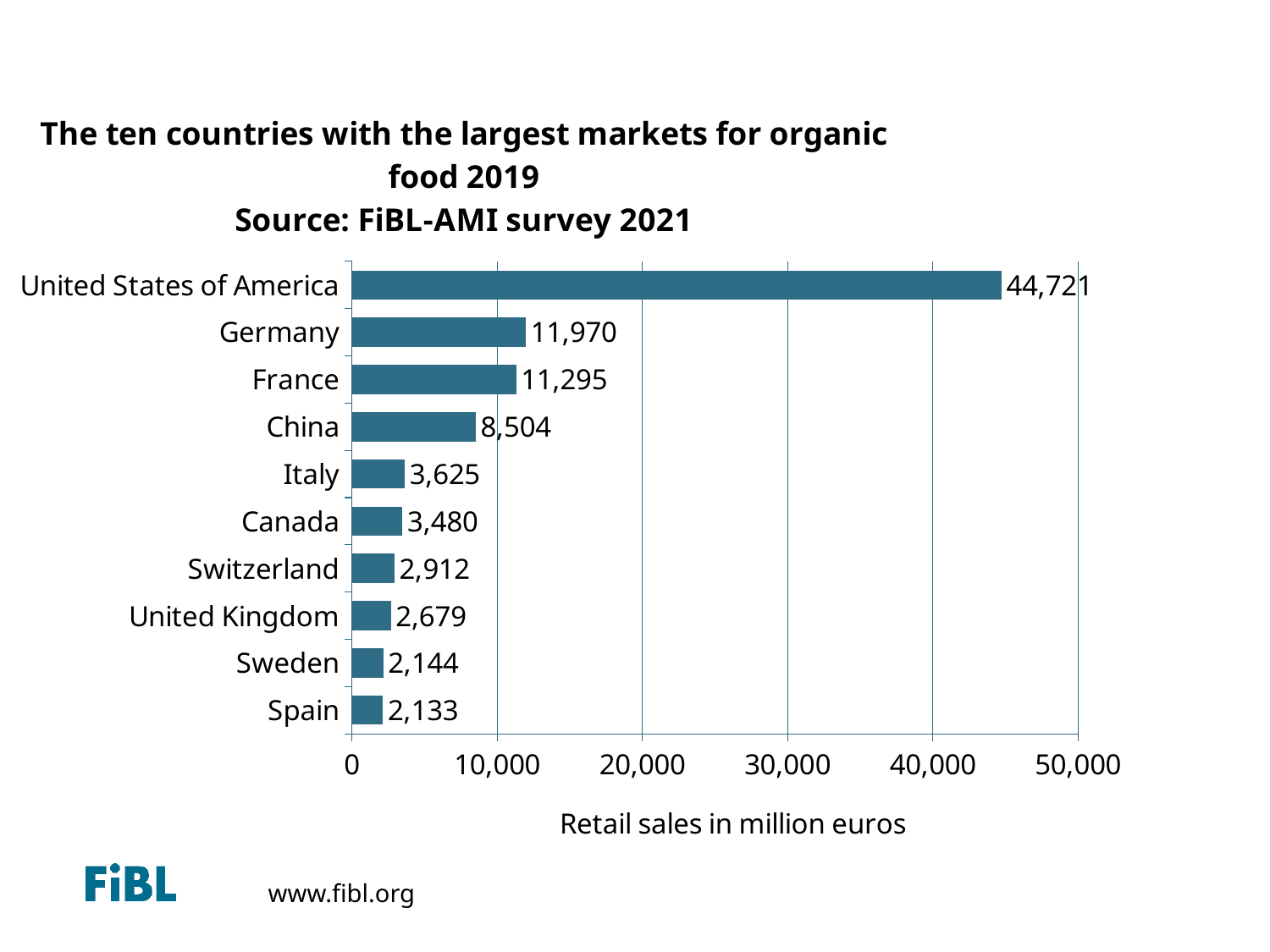
How many countries are shown in the chart? 10 What are the retail sales for Switzerland? 2,912 Which country has the largest organic food market? United States of America Is the value for France greater or less than 10,000? greater Which has higher retail sales, Italy or Canada? Italy What kind of chart is this? Bar chart What is the label of the horizontal axis? Retail sales in million euros What is the difference between the retail sales of the United States of America and China? 36,217 What is the difference between the retail sales of Germany and France? 675 What are the retail sales for Germany? 11,970 Which country has the smallest value shown? Spain What are the retail sales for China? 8,504